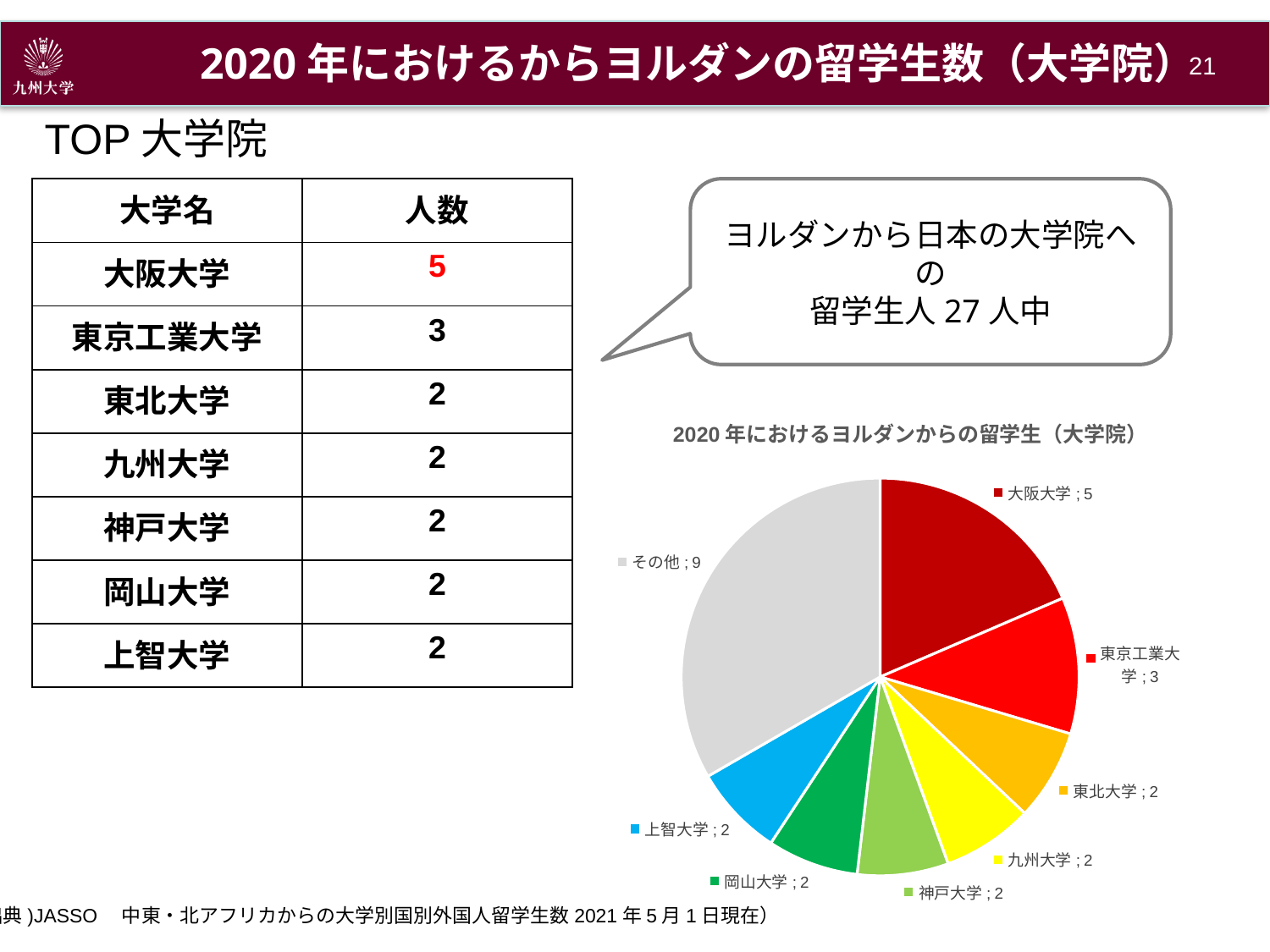
Among the named universities in the pie chart, which has the highest value? 大阪大学 In the pie chart, what is the value for 東京工業大学? 3 What is the difference between the values for 大阪大学 and 東京工業大学 in the pie chart? 2 In the pie chart, which is larger, the value for 大阪大学 or the value for 東北大学? 大阪大学 Which slice of the pie chart is the largest? その他 How many slices does the pie chart have? 8 In the pie chart, what is the value for 上智大学? 2 In the pie chart, what is the value for その他? 9 What is the title of the pie chart? 2020年におけるヨルダンからの留学生（大学院） What is the difference between the values for その他 and 大阪大学 in the pie chart? 4 What kind of chart is shown on the slide? pie chart In the pie chart, what is the value for 大阪大学? 5